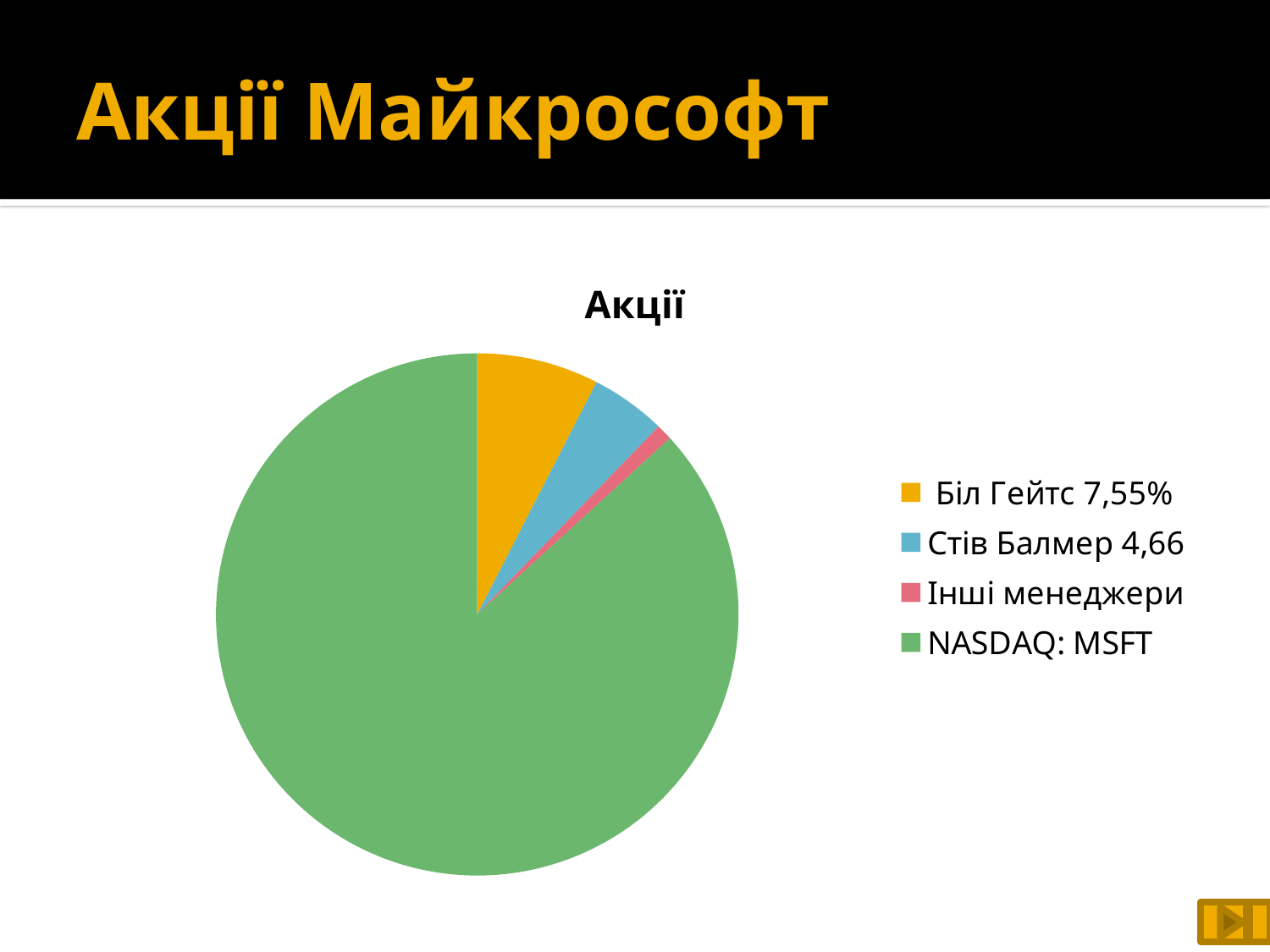
What value is shown in the legend for Біл Гейтс? 7,55% What value is shown in the legend for Стів Балмер? 4,66 Which category has the smallest slice of the pie? Інші менеджери What colour is the NASDAQ: MSFT slice? green What kind of chart is shown on the slide? pie chart Which slice is larger, NASDAQ: MSFT or Інші менеджери? NASDAQ: MSFT Which slice is larger, Біл Гейтс or Стів Балмер? Біл Гейтс Which category has the largest slice of the pie? NASDAQ: MSFT What is the title of the chart? Акції How many slices does the pie chart have? 4